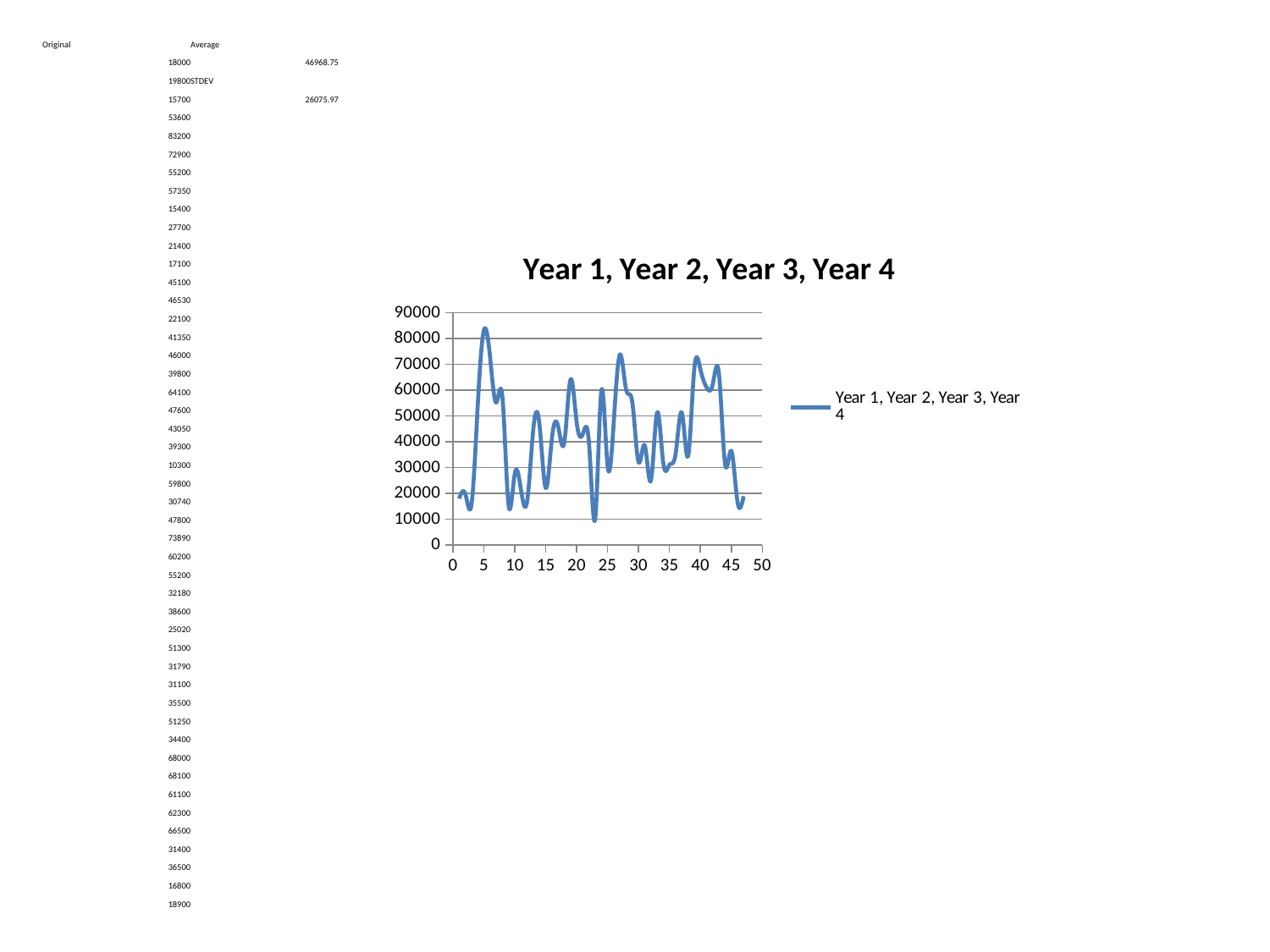
Around which x value does the line reach its lowest point? 23 How many series does the chart's legend list? 1 What colour is the plotted line in the chart? blue What is the title of the chart? Year 1, Year 2, Year 3, Year 4 Is the value of the line at x = 40 greater or less than 60000? greater What kind of chart is shown on the slide? line chart Is the peak value of the line, near x = 5, greater or less than 80000? greater Is the value of the line at x = 27 greater or less than 70000? greater Which is larger: the value of the line at x = 5 or at x = 23? x = 5 Around which x value does the line reach its highest point? 5